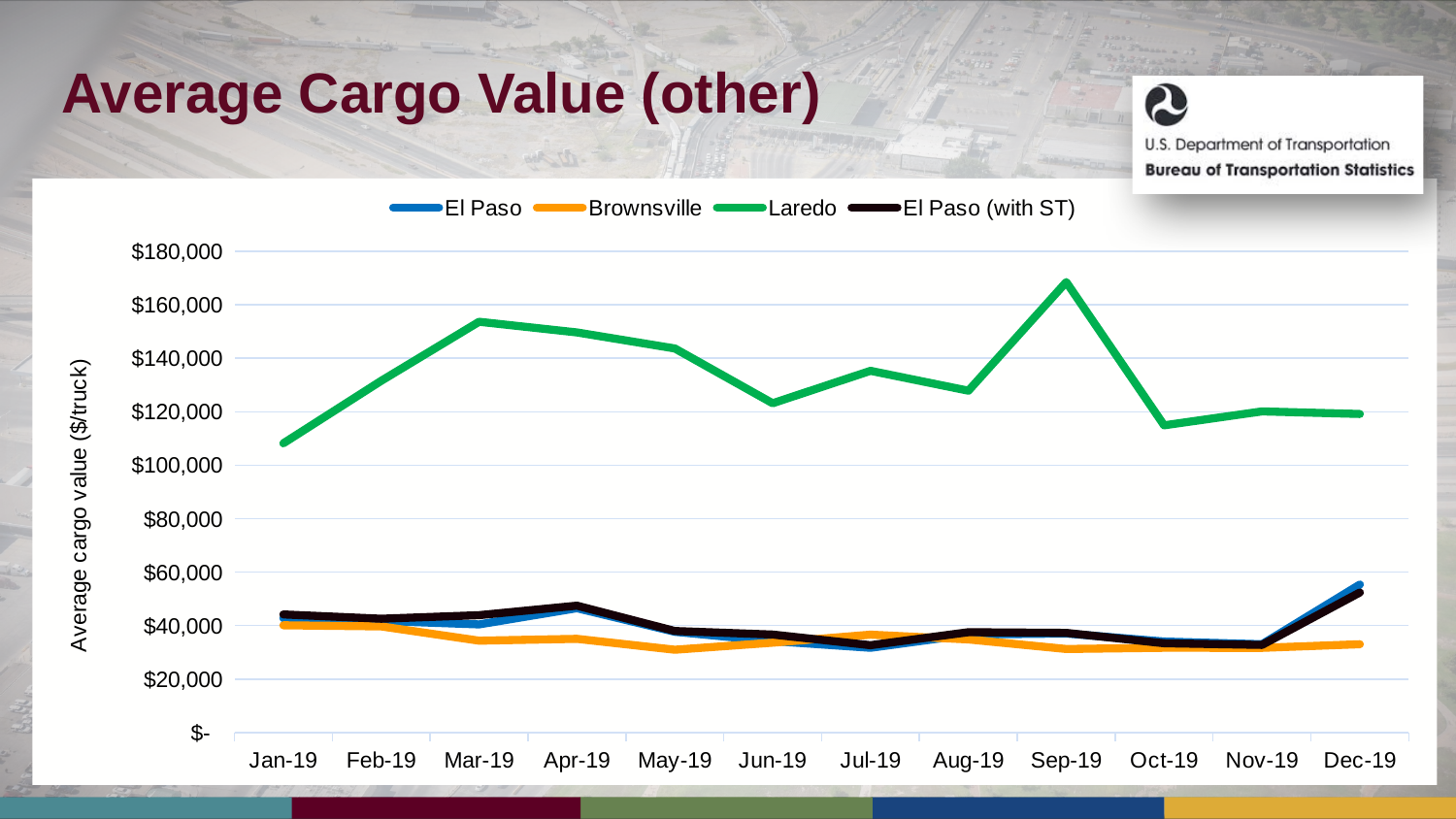
Does the Laredo series rise or fall from Sep-19 to Oct-19? fall In which month does the Laredo series reach its highest value? Sep-19 How many months are plotted along the x axis? 12 What kind of chart is shown on the slide? line chart Which series has the highest values across all months? Laredo How many series does the legend list? 4 Is the value for El Paso in Dec-19 greater or less than $40,000? greater In which month does the Laredo series have its lowest value? Jan-19 Is the value for Laredo in Sep-19 greater or less than $160,000? greater What is the label on the y axis? Average cargo value ($/truck) Is the value for Laredo in Oct-19 greater or less than $120,000? less